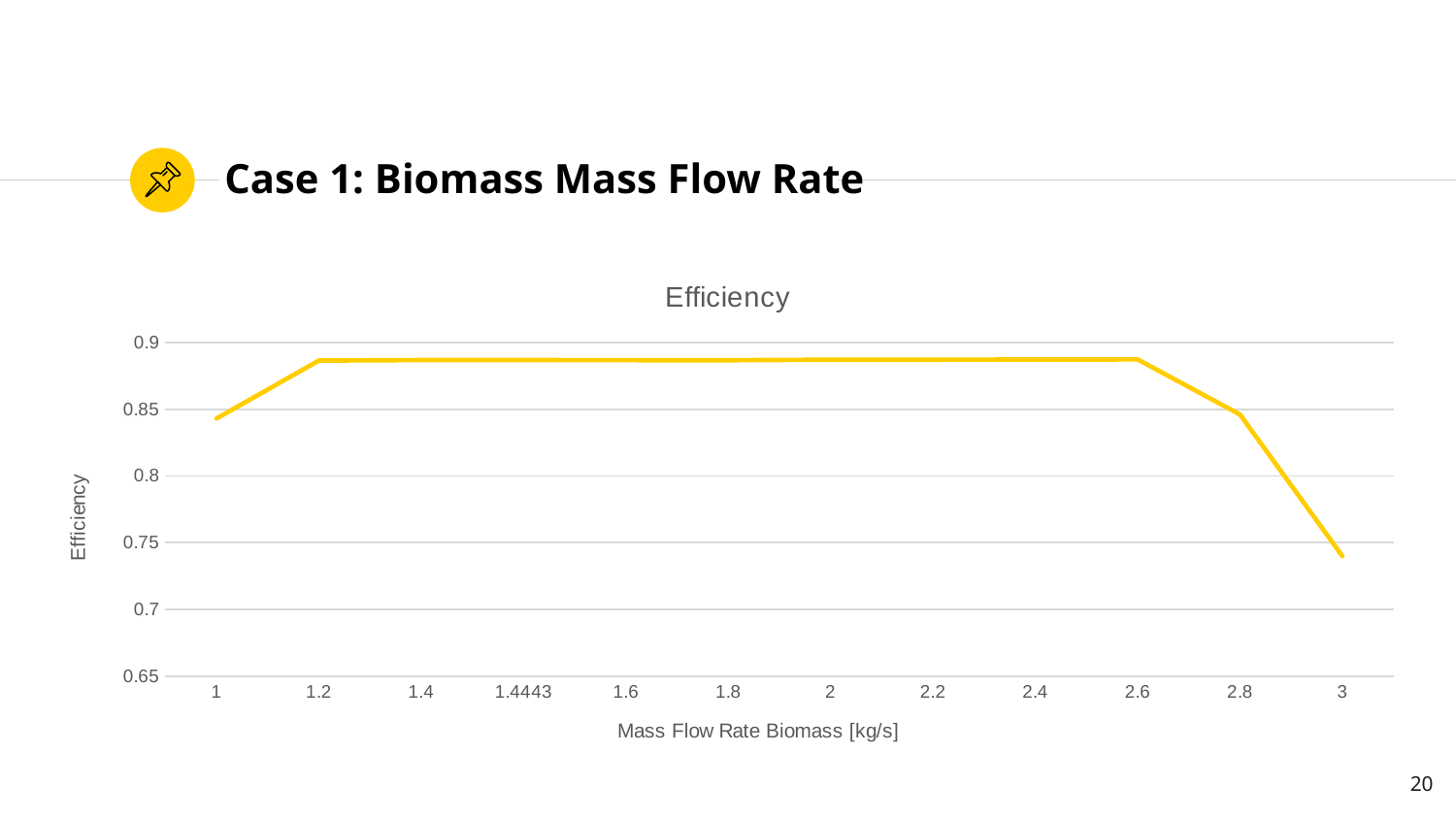
Is the efficiency at a mass flow rate of 2.6 kg/s greater or less than 0.9? less Which has the higher efficiency: a mass flow rate of 1 kg/s or 3 kg/s? 1 kg/s What is the title of the chart? Efficiency Is the efficiency at a mass flow rate of 3 kg/s greater or less than 0.75? less What kind of chart is shown on the slide? line chart Is the efficiency at a mass flow rate of 3 kg/s greater or less than 0.7? greater What is the label of the x axis? Mass Flow Rate Biomass [kg/s] At which mass flow rate is the efficiency lowest? 3 How many data points are plotted along the x axis of the Efficiency chart? 12 Does the efficiency rise or fall as the mass flow rate increases from 2.6 to 3 kg/s? fall